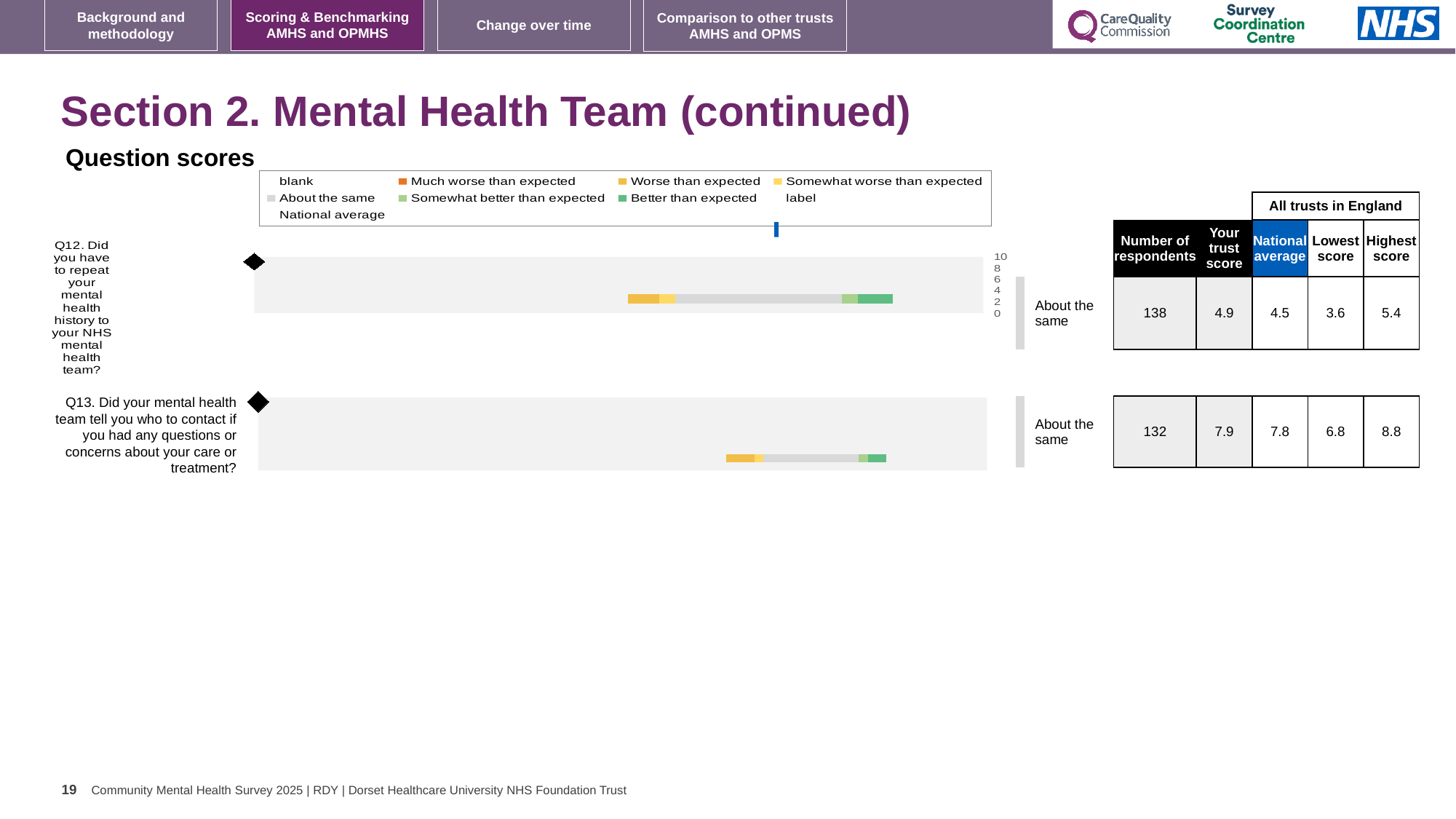
What is the trust score for Q13 (Did your mental health team tell you who to contact)? 7.9 What is the difference between the highest and lowest scores for Q13? 2.0 What is the lowest score among all trusts in England for Q12? 3.6 What is the number of respondents for Q12? 138 What kind of chart is used to show the question scores for Q12 and Q13? bar chart What is the highest score among all trusts in England for Q13? 8.8 What is the national average score for Q12? 4.5 Which is larger for Q12: the trust score or the national average? the trust score What is the difference between the trust score and the national average for Q12? 0.4 What colour represents 'Better than expected' in the legend? green What benchmark category is shown for Q13? About the same How many questions (Q12 and Q13) are plotted on the slide? 2